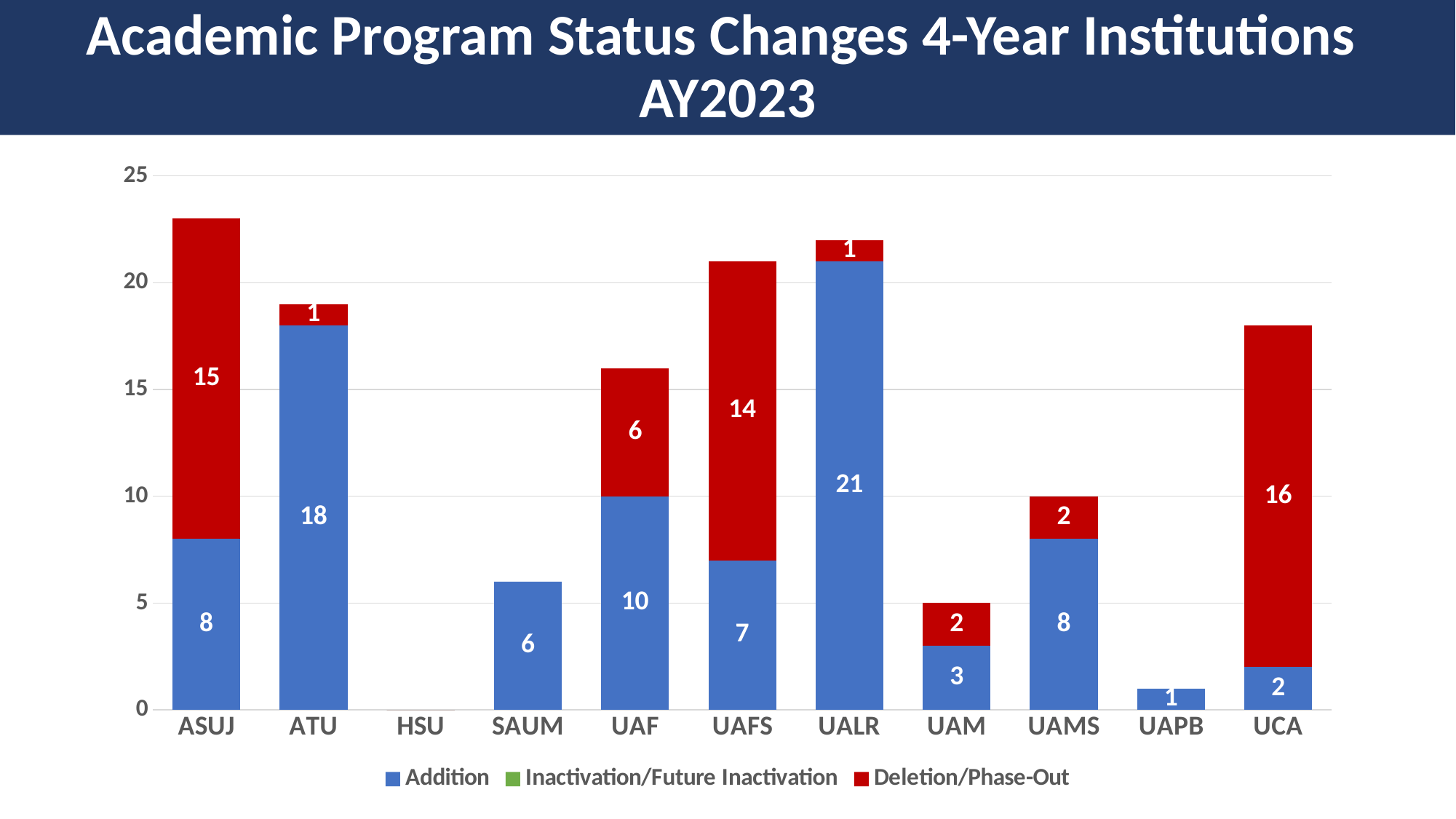
What is the Addition value for UALR? 21 What is the difference between the Deletion/Phase-Out values for ASUJ and UAF? 9 What is the Addition value for SAUM? 6 Which institution has the highest Deletion/Phase-Out value? UCA What is the total of the stacked bar for UAFS? 21 How many institutions are shown on the x axis? 11 Which is larger, the Addition value for ATU or the Addition value for UAF? ATU What kind of chart is shown on the slide? Stacked bar chart How many series does the legend list? 3 What is the total of the stacked bar for ASUJ? 23 What is the Deletion/Phase-Out value for UCA? 16 Which institution has the highest Addition value? UALR